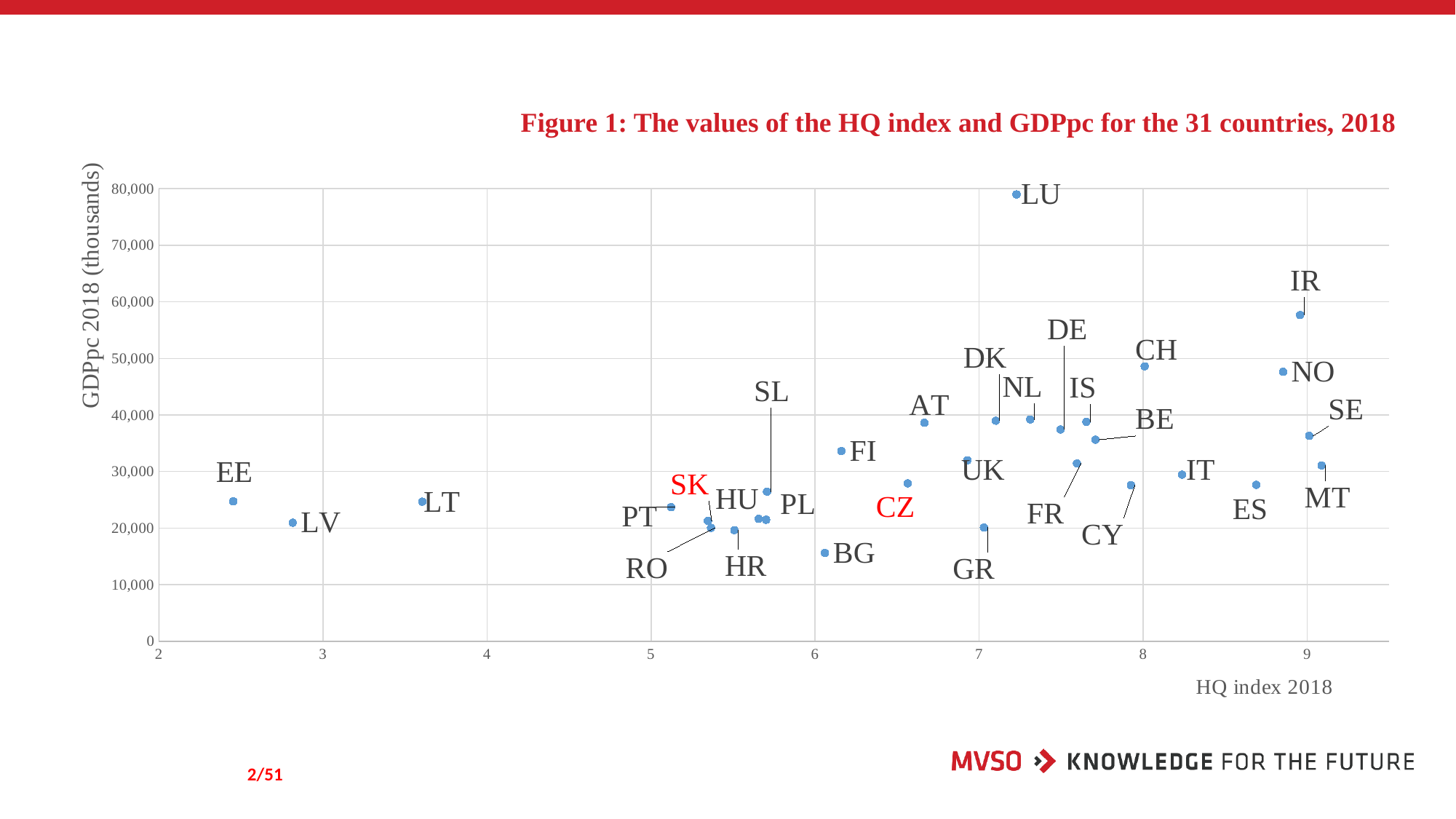
Is the HQ index 2018 value for EE greater or less than 3? less What kind of chart is shown on the slide? scatter chart Which country has the highest GDPpc 2018 in the chart? LU Is the GDPpc 2018 value for GR greater or less than 30,000? less Which country has the lowest GDPpc 2018 in the chart? BG Which two country labels are shown in red on the chart? SK and CZ Which country has the lowest HQ index 2018 in the chart? EE How many countries are plotted in the chart, according to its title? 31 Is the GDPpc 2018 value for LU greater or less than 70,000? greater Which has the higher GDPpc 2018, NO or ES? NO What is the title of the chart? Figure 1: The values of the HQ index and GDPpc for the 31 countries, 2018